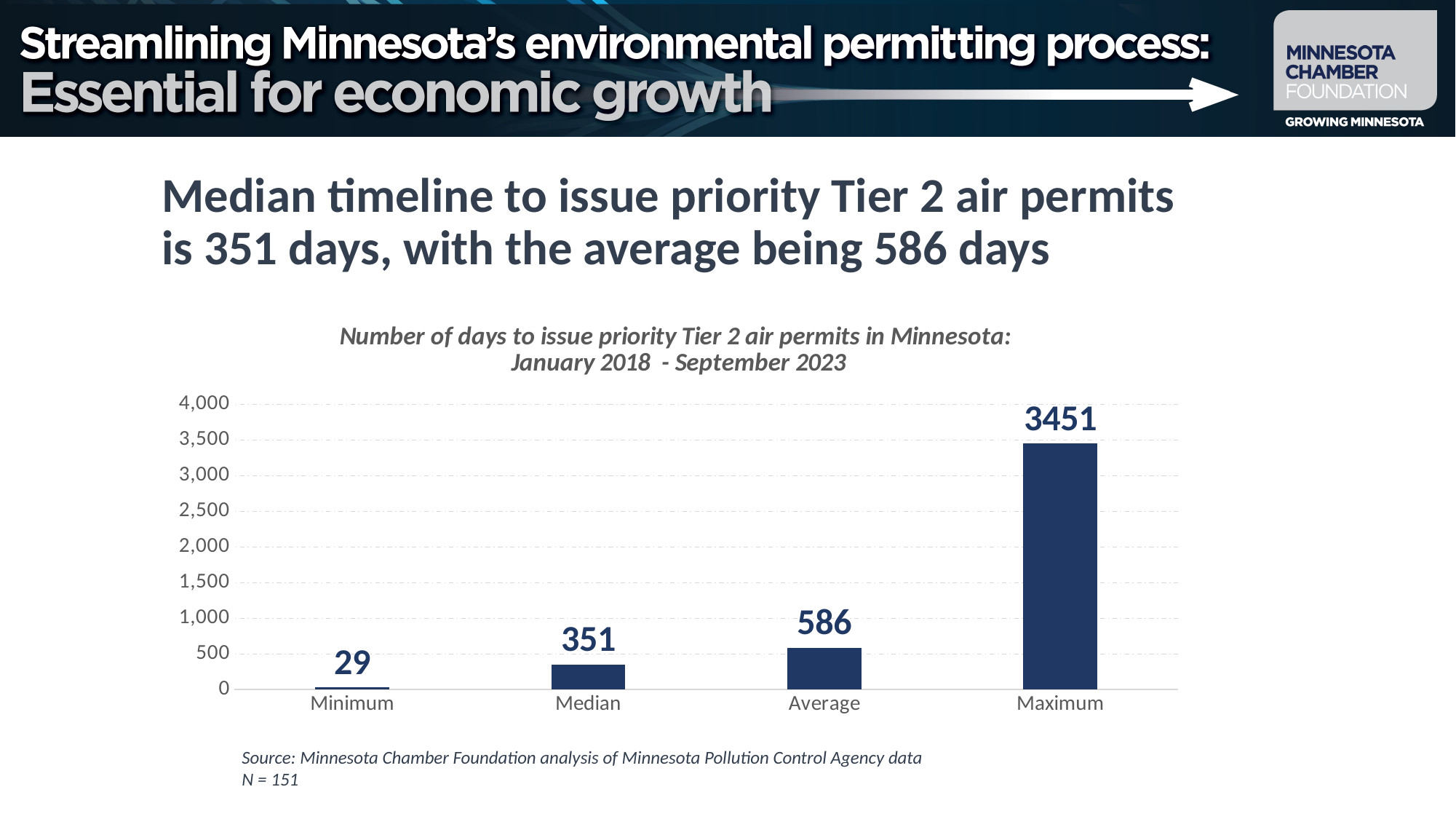
What is the value for Average in the chart? 586 What is the value for Minimum in the chart? 29 Is the value for Maximum greater or less than 3,000? greater What is the difference between the Average and Median values? 235 Which is larger, the value for Average or the value for Median? Average Which category has the lowest value? Minimum What is the value for Maximum in the chart? 3451 What is the value for Median in the chart? 351 Which category has the highest value? Maximum What kind of chart is shown on the slide? Bar chart How many categories are shown on the x axis? 4 What is the difference between the Maximum and Minimum values? 3422